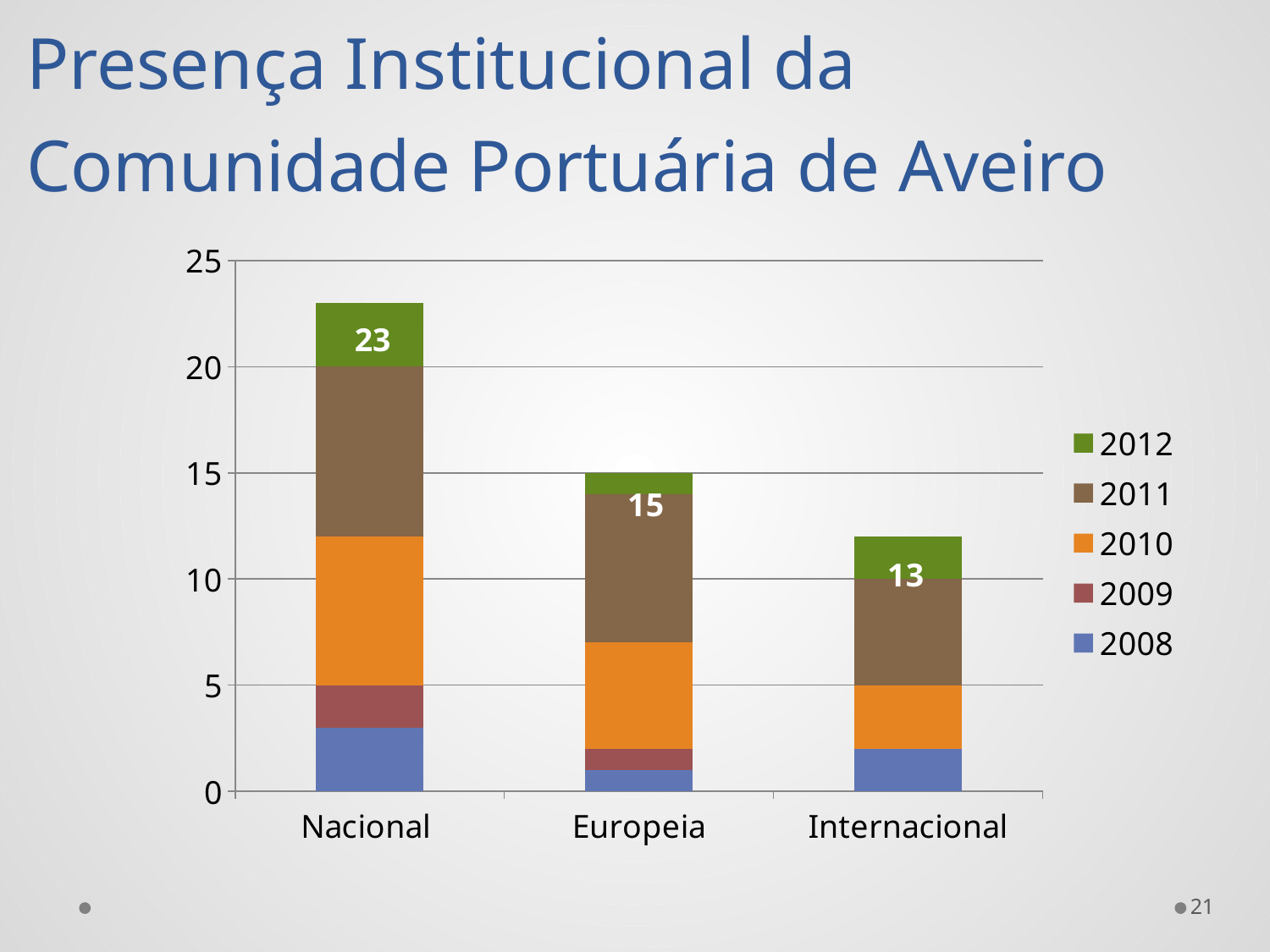
What is the difference between the totals for Nacional and Europeia? 8 What is the total value of the stacked bar for Internacional? 13 How many series does the legend list? 5 How many categories are shown on the x axis of the chart? 3 Which category has the highest total? Nacional What is the total value of the stacked bar for Nacional? 23 What is the total value of the stacked bar for Europeia? 15 Which category has the lowest total? Internacional Is the 2011 value for Nacional greater or less than 5? greater What kind of chart is shown on the slide? Stacked bar chart Which year is shown in green in the legend? 2012 Which has a larger total, Europeia or Internacional? Europeia